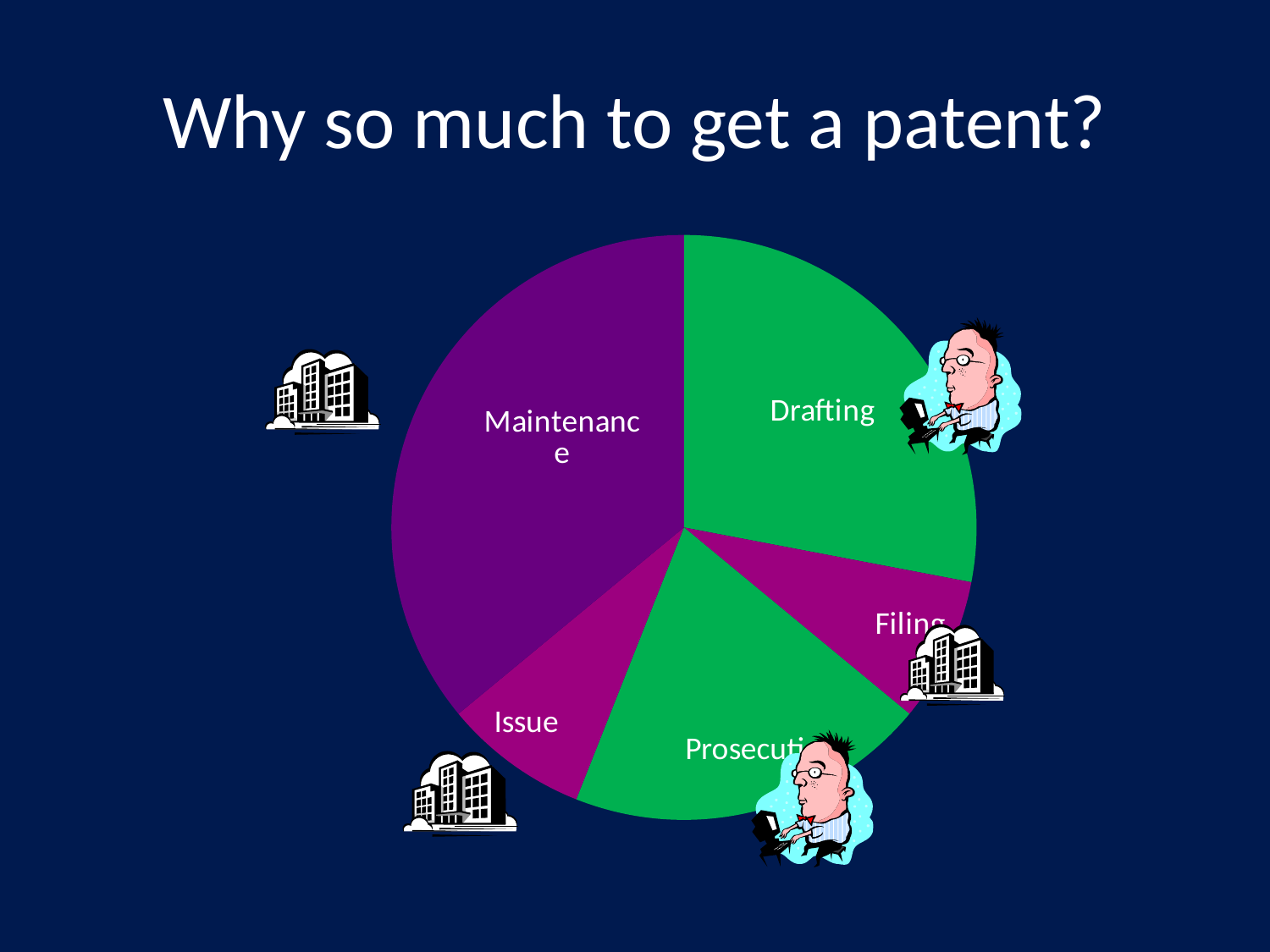
Which slice is larger, Drafting or Filing? Drafting Which slice is larger, Prosecution or Issue? Prosecution How many slices does the pie chart have? 5 What is the title of the slide containing the pie chart? Why so much to get a patent? Which slice of the pie chart is the largest? Maintenance What kind of chart is shown on the slide? pie chart What colour is the Maintenance slice of the pie chart? purple Which slice is larger, Maintenance or Issue? Maintenance